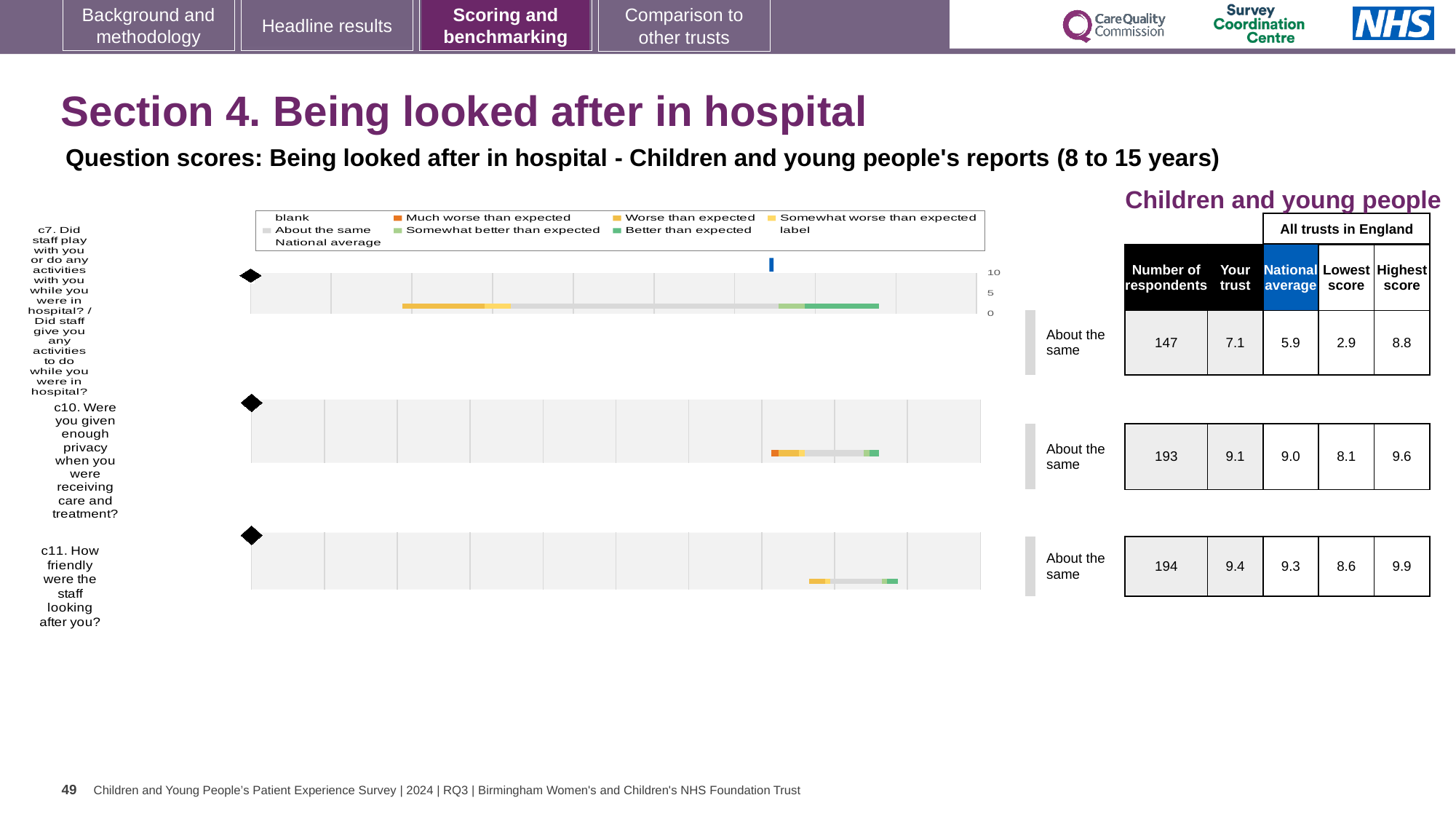
Which question has the highest 'Your trust' score? c11. How friendly were the staff looking after you? How many questions (chart rows) are plotted on the slide? 3 For c7, what is the difference between the highest score and the lowest score across all trusts in England? 5.9 How many respondents answered c11 (How friendly were the staff looking after you?)? 194 For c10, which is larger: the 'Your trust' score or the national average? Your trust According to the legend, what does the blue marker on the charts represent? National average What benchmark category is shown for c11 (How friendly were the staff looking after you?)? About the same What is the lowest score across all trusts in England for c11? 8.6 What kind of chart is used to show the question scores on this slide? bar chart What is the national average score for c10 (Were you given enough privacy when you were receiving care and treatment?)? 9.0 What is the 'Your trust' score for c7 (Did staff play with you or do any activities with you while you were in hospital?)? 7.1 Which question has the lowest 'Your trust' score? c7. Did staff play with you or do any activities with you while you were in hospital?